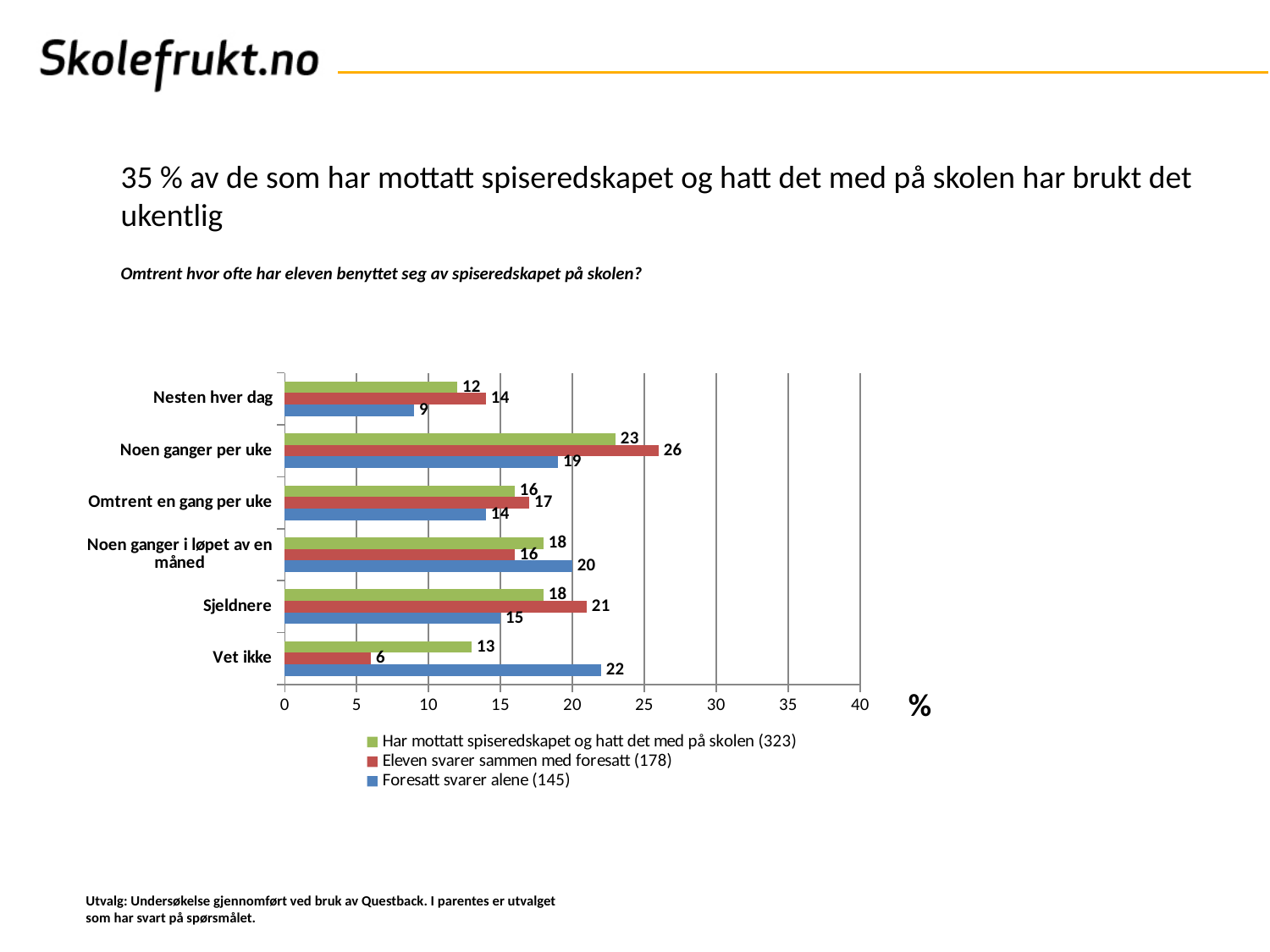
How many categories are shown on the chart? 6 What unit is shown at the end of the horizontal axis? % What is the value for 'Noen ganger per uke' in the 'Eleven svarer sammen med foresatt (178)' series? 26 What kind of chart is shown on the slide? Bar chart What is the difference between the 'Eleven svarer sammen med foresatt (178)' and 'Foresatt svarer alene (145)' values for 'Vet ikke'? 16 For 'Sjeldnere', which series has the larger value: 'Eleven svarer sammen med foresatt (178)' or 'Foresatt svarer alene (145)'? Eleven svarer sammen med foresatt (178) What is the value for 'Vet ikke' in the 'Foresatt svarer alene (145)' series? 22 Which category has the highest value in the 'Har mottatt spiseredskapet og hatt det med på skolen (323)' series? Noen ganger per uke Which category has the lowest value in the 'Eleven svarer sammen med foresatt (178)' series? Vet ikke What is the value for 'Nesten hver dag' in the 'Har mottatt spiseredskapet og hatt det med på skolen (323)' series? 12 What is the value for 'Noen ganger i løpet av en måned' in the 'Foresatt svarer alene (145)' series? 20 How many series does the legend list? 3